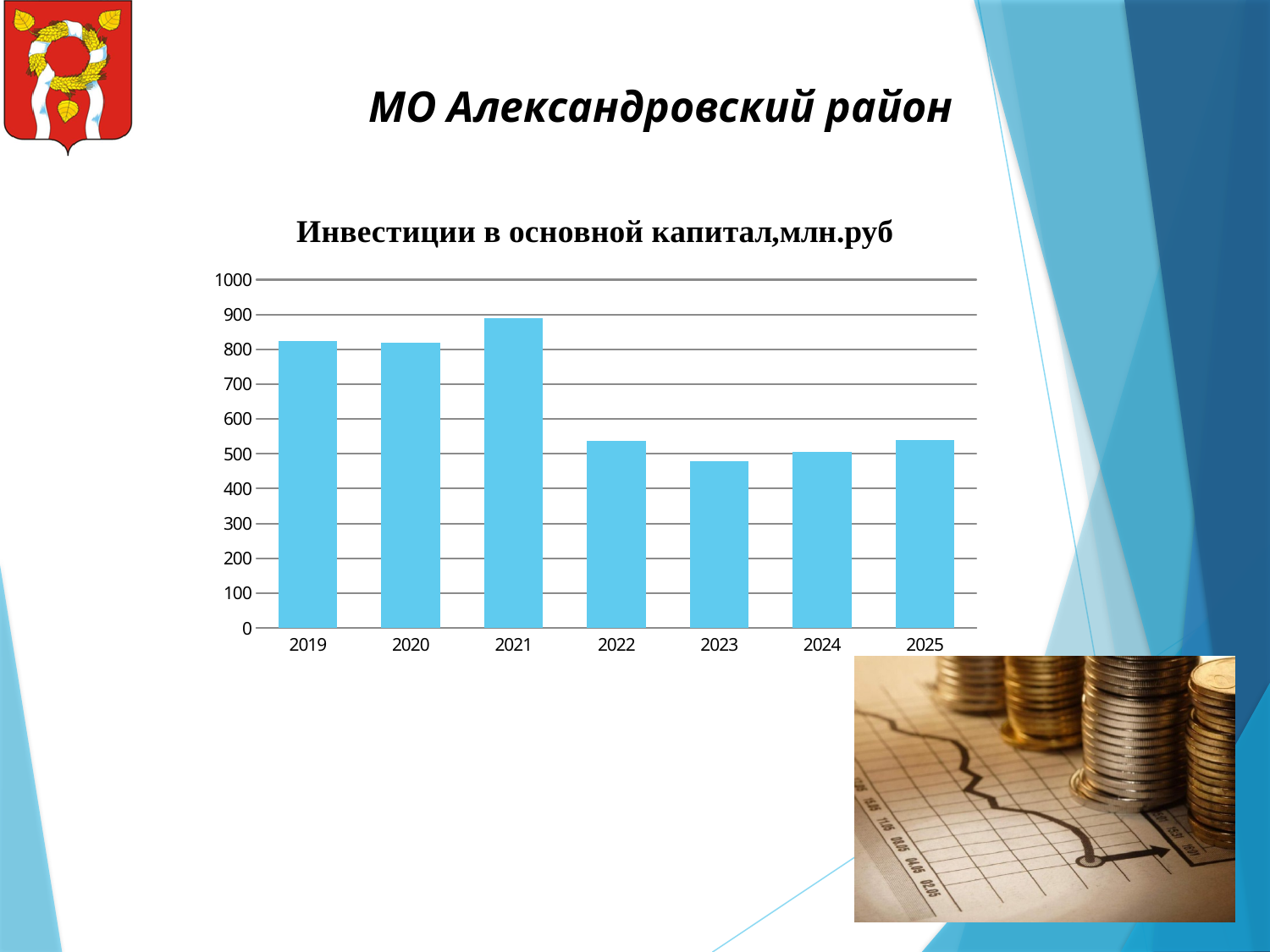
Which year has the highest value in the chart? 2021 What kind of chart is shown on the slide? bar chart Is the value for 2022 greater or less than 500? greater Do the values rise or fall from 2021 to 2023? fall Which is larger, the value for 2021 or the value for 2022? 2021 Is the value for 2023 greater or less than 500? less Which is larger, the value for 2023 or the value for 2019? 2019 Is the value for 2019 greater or less than 900? less Which year has the lowest value in the chart? 2023 What is the title of the chart? Инвестиции в основной капитал,млн.руб How many years are shown on the x axis of the chart? 7